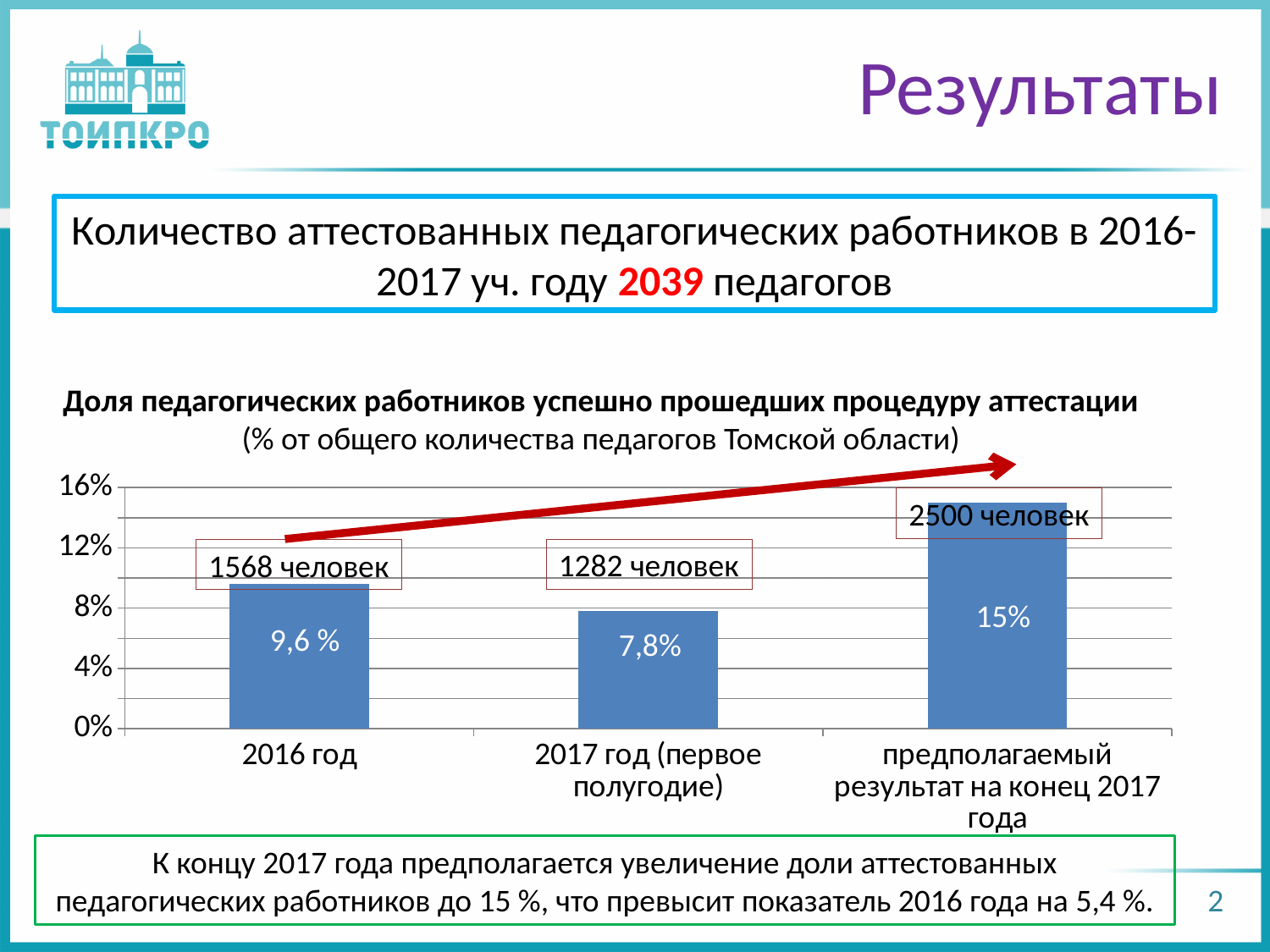
What kind of chart is shown on the slide? bar chart By how many percentage points does the value for "предполагаемый результат на конец 2017 года" exceed the value for "2016 год"? 5,4 Is the value for "2017 год (первое полугодие)" greater or less than 8%? less By how many percentage points does the value for "2016 год" exceed the value for "2017 год (первое полугодие)"? 1,8 What is the value shown for the bar labelled "2017 год (первое полугодие)"? 7,8% What is the value shown for the bar labelled "предполагаемый результат на конец 2017 года"? 15% Which category has the highest bar in the chart? предполагаемый результат на конец 2017 года How many categories (bars) are shown in the chart? 3 Which is larger: the value for "2016 год" or the value for "2017 год (первое полугодие)"? 2016 год What is the value shown for the bar labelled "2016 год"? 9,6 % What number of people is shown in the label above the bar for "2016 год"? 1568 человек Which category has the lowest bar in the chart? 2017 год (первое полугодие)